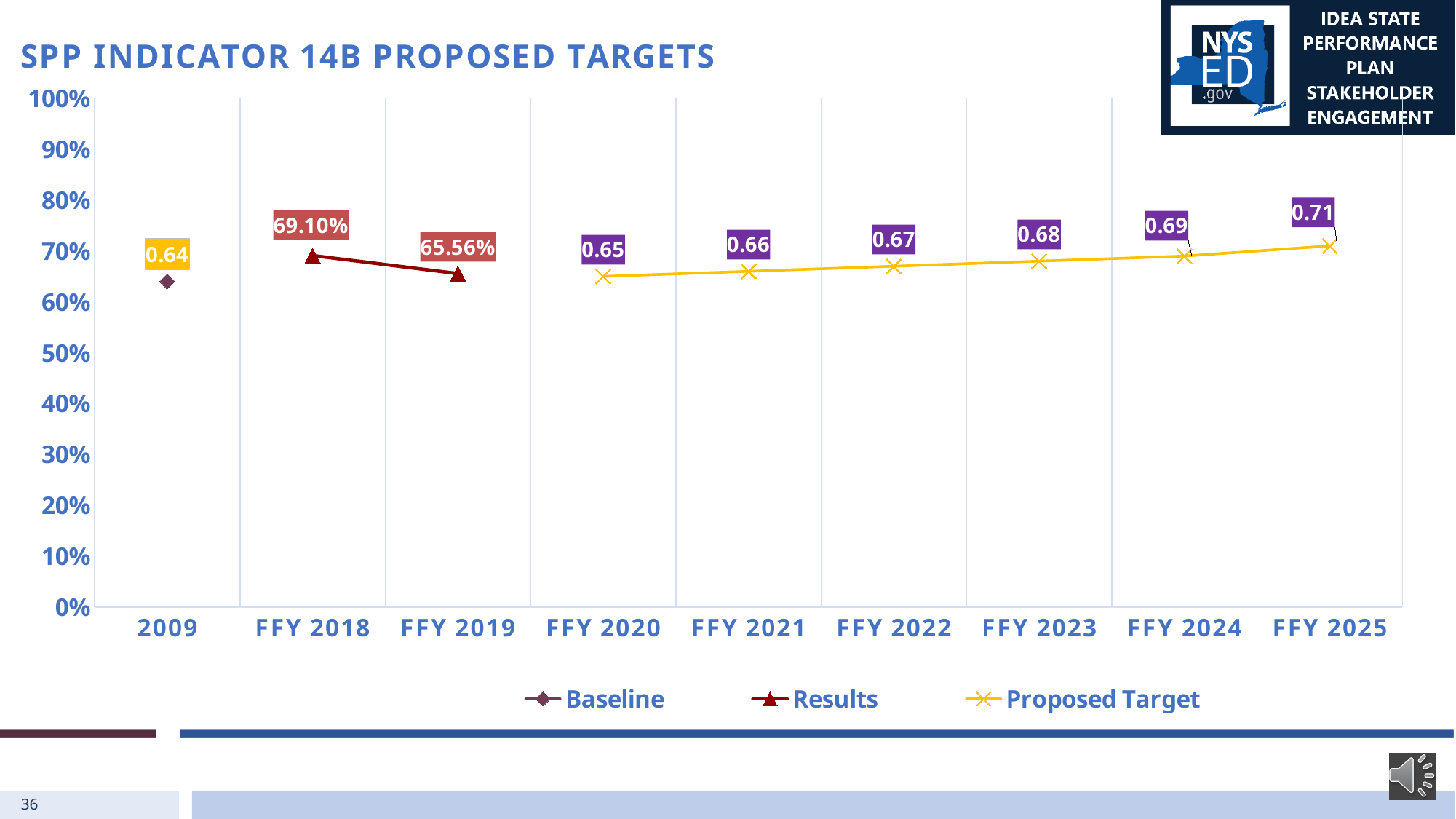
What is the Results value for FFY 2018? 69.10% What is the Proposed Target for FFY 2025? 0.71 How many series does the legend list? 3 Do the Proposed Target values rise or fall from FFY 2020 to FFY 2025? rise What is the Results value for FFY 2019? 65.56% Which is larger, the Results value for FFY 2018 or for FFY 2019? FFY 2018 What is the Baseline value for 2009? 0.64 Which year has the highest Proposed Target? FFY 2025 What is the title of the chart? SPP INDICATOR 14B PROPOSED TARGETS What is the Proposed Target for FFY 2022? 0.67 What is the difference between the Results values for FFY 2018 and FFY 2019? 3.54% Which year has the lowest Proposed Target? FFY 2020